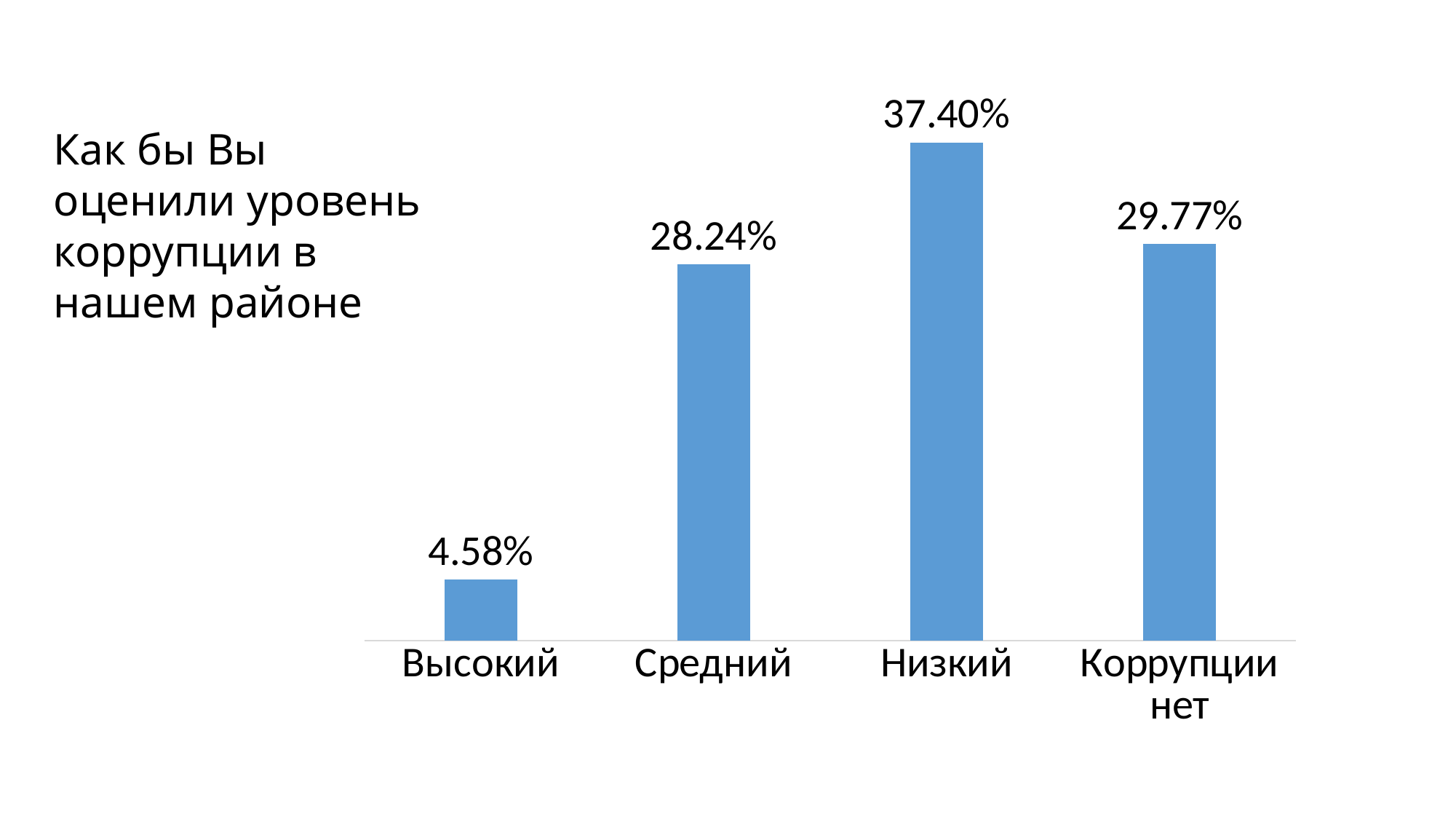
What is the value for Средний? 28.24% Which category has the lowest value? Высокий What is the difference between the values for Низкий and Средний? 9.16% What is the title of the chart? Как бы Вы оценили уровень коррупции в нашем районе What is the difference between the values for Коррупции нет and Высокий? 25.19% What is the value for Низкий? 37.40% Which is larger, the value for Средний or the value for Коррупции нет? Коррупции нет What is the value for Высокий? 4.58% What kind of chart is shown on the slide? Bar chart Which category has the highest value? Низкий How many categories are shown in the chart? 4 What is the value for Коррупции нет? 29.77%